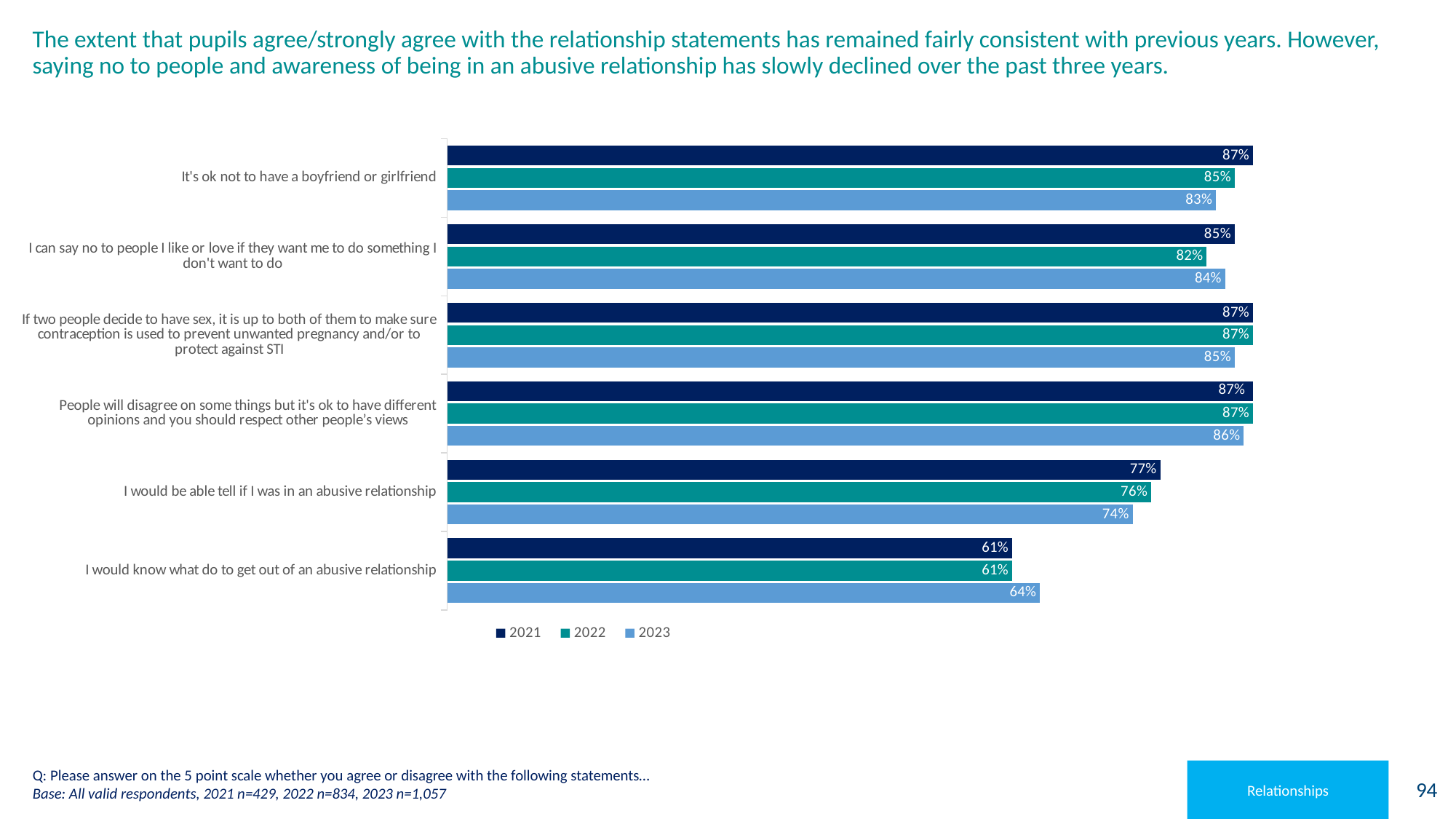
What is the 2023 value for "It's ok not to have a boyfriend or girlfriend"? 83% What is the 2022 value for "I can say no to people I like or love if they want me to do something I don't want to do"? 82% How many statements (categories) are shown on the chart? 6 Do the values for "It's ok not to have a boyfriend or girlfriend" rise or fall from 2021 to 2023? Fall Which statement has the lowest 2021 value? I would know what do to get out of an abusive relationship Which year does the lightest blue bar represent in the legend? 2023 What is the 2021 value for "I would be able tell if I was in an abusive relationship"? 77% What is the 2023 value for "I would know what do to get out of an abusive relationship"? 64% Which is larger for "I would know what do to get out of an abusive relationship": the 2021 value or the 2023 value? 2023 What kind of chart is shown on the slide? Bar chart How many series does the legend list? 3 What is the difference between the 2021 and 2023 values for "I would be able tell if I was in an abusive relationship"? 3%